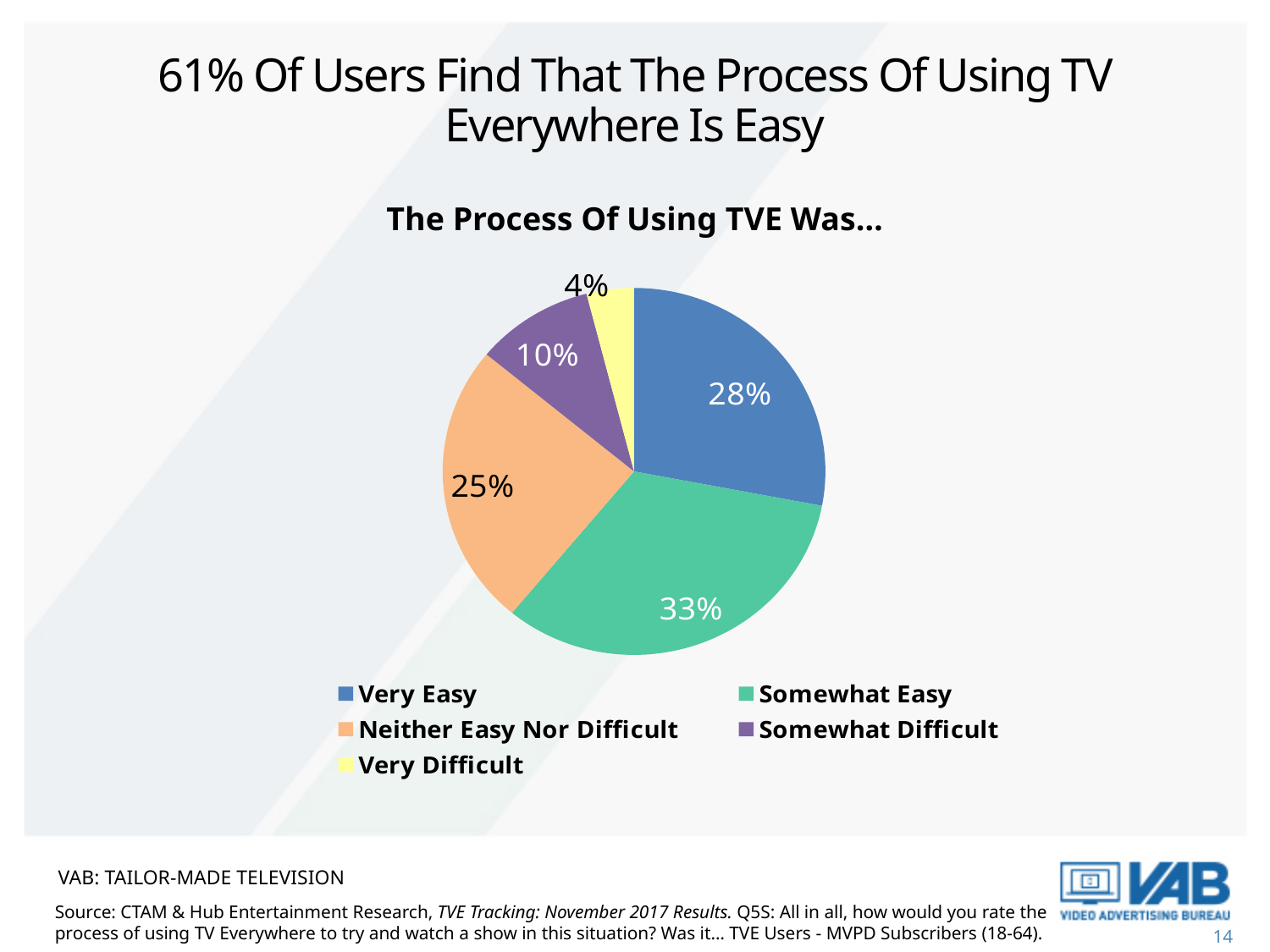
How many categories does the legend list? 5 What is the difference in percentage points between Somewhat Easy and Very Easy? 5 Which response category has the smallest share of the pie? Very Difficult What percentage of users said the process was Very Difficult? 4% Which is larger, the share for Neither Easy Nor Difficult or the share for Somewhat Difficult? Neither Easy Nor Difficult What percentage of users said the process was Somewhat Difficult? 10% Which response category has the largest share of the pie? Somewhat Easy What percentage of users said the process was Neither Easy Nor Difficult? 25% What type of chart is shown on the slide? Pie chart What percentage of users said the process of using TVE was Somewhat Easy? 33% What is the title of the chart? The Process Of Using TVE Was… What percentage of users said the process of using TVE was Very Easy? 28%